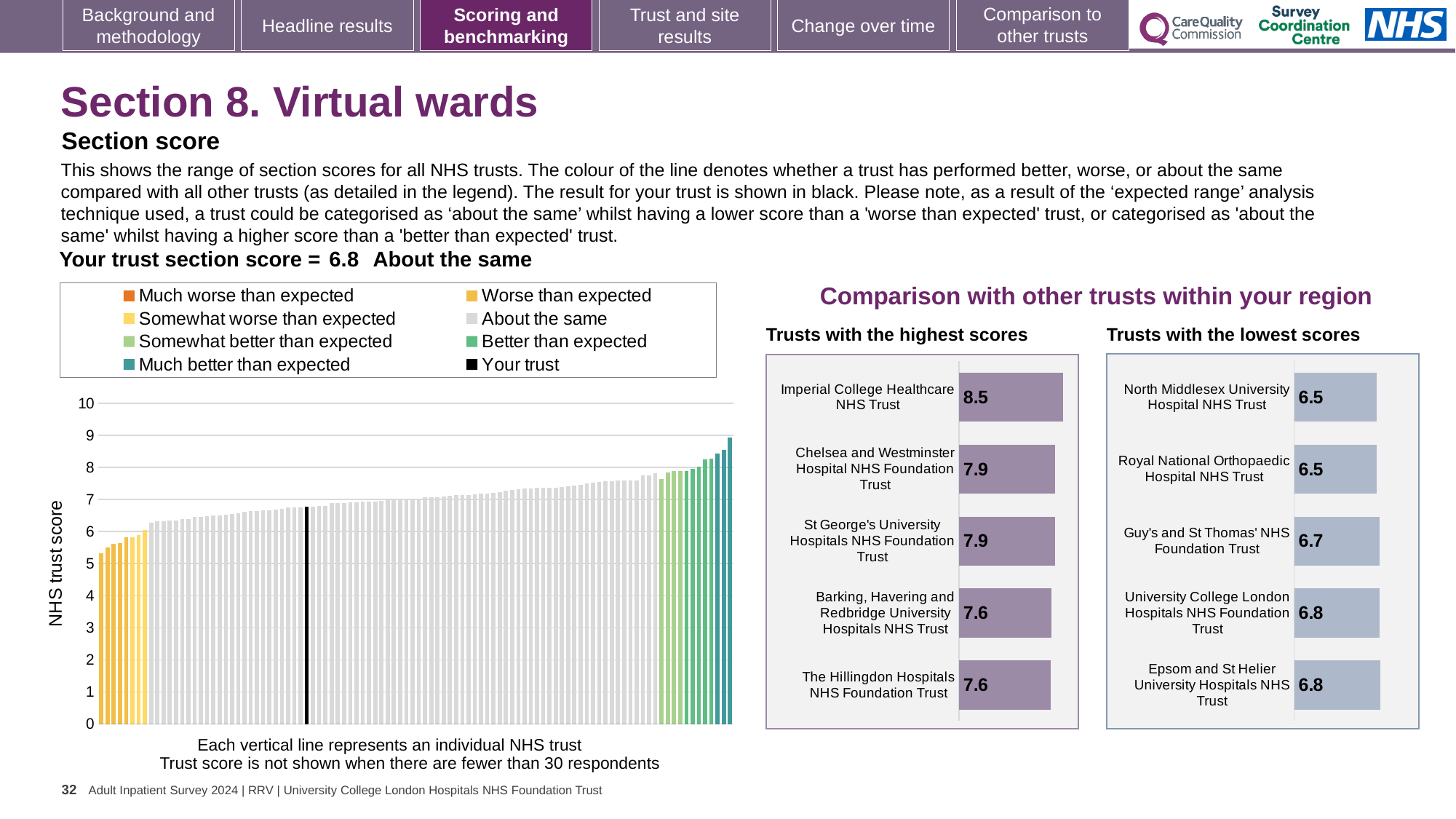
In the 'Trusts with the lowest scores' chart, what is the score for Guy's and St Thomas' NHS Foundation Trust? 6.7 In the 'Trusts with the lowest scores' chart, what is the difference between the scores of Guy's and St Thomas' NHS Foundation Trust and North Middlesex University Hospital NHS Trust? 0.2 In the 'Trusts with the highest scores' chart, what is the score for Imperial College Healthcare NHS Trust? 8.5 In the main 'NHS trust score' chart, is the value of the tallest bar greater or less than 8? greater In the 'Trusts with the highest scores' chart, what is the difference between the scores of Imperial College Healthcare NHS Trust and The Hillingdon Hospitals NHS Foundation Trust? 0.9 How many trusts are shown in the 'Trusts with the lowest scores' chart? 5 What kind of chart is the 'Trusts with the highest scores' chart? bar chart How many entries does the legend of the main 'NHS trust score' chart list? 8 In the 'Trusts with the highest scores' chart, which trust has the highest score? Imperial College Healthcare NHS Trust In the 'Trusts with the lowest scores' chart, which has the larger score: University College London Hospitals NHS Foundation Trust or Royal National Orthopaedic Hospital NHS Trust? University College London Hospitals NHS Foundation Trust In the 'Trusts with the highest scores' chart, what is the score for Barking, Havering and Redbridge University Hospitals NHS Trust? 7.6 In the main 'NHS trust score' chart, do the bar values rise or fall from left to right? rise